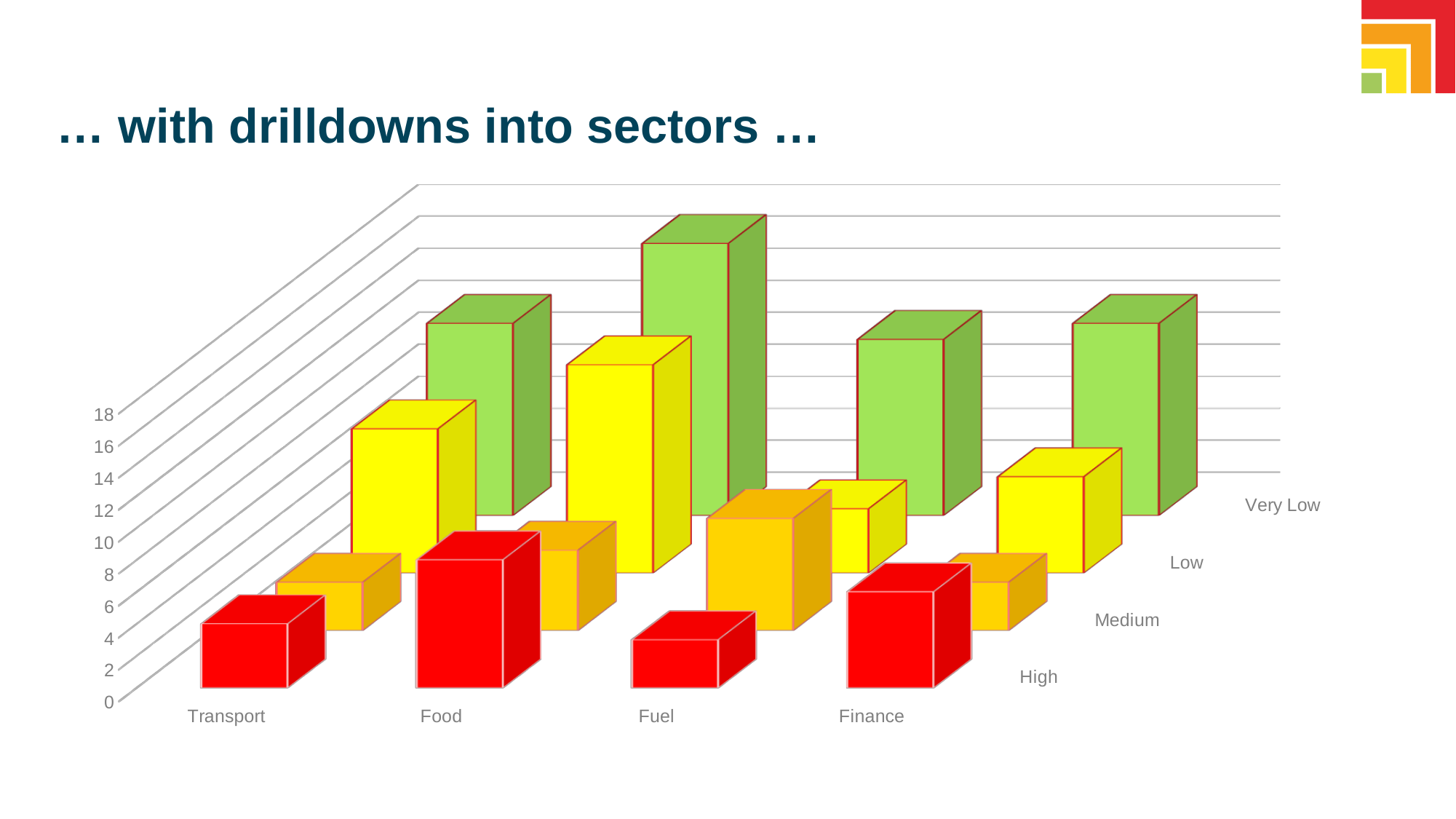
What is the title of the slide containing the chart? … with drilldowns into sectors … Which sector has the tallest bar in the Medium series? Fuel Which sector has the shortest bar in the High series? Fuel In the Very Low series, is the bar for Fuel or for Finance taller? Finance Which sector has the shortest bar in the Low series? Fuel How many sector categories are shown along the x axis? 4 What colour are the bars of the High series? red In the High series, is the bar for Food or for Fuel taller? Food Which sector has the tallest bar in the Very Low series? Food How many series (High, Medium, Low, Very Low) does the chart plot? 4 Which sector has the tallest bar in the High series? Food What kind of chart is shown on the slide? bar chart